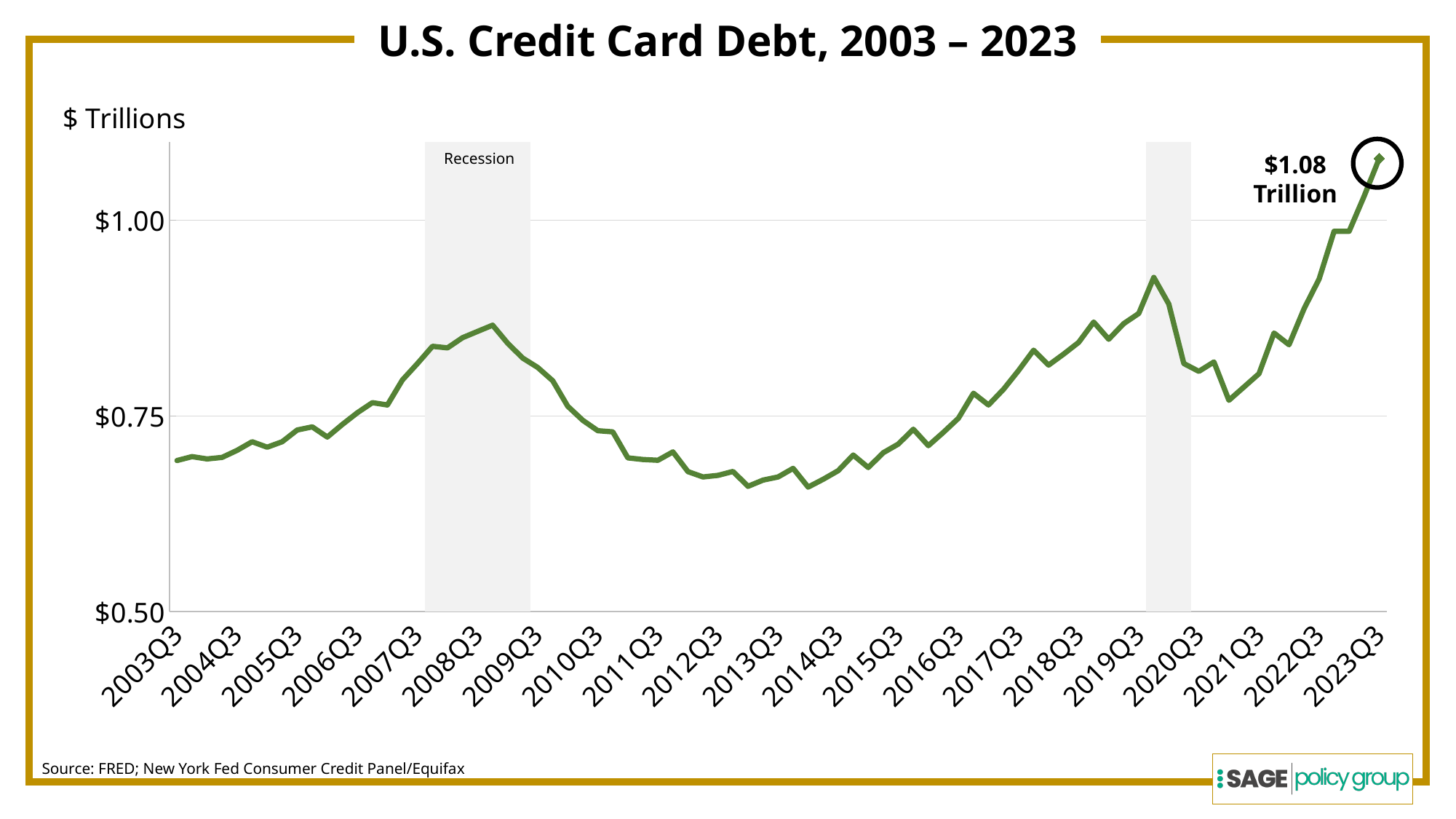
What is the value of U.S. credit card debt at 2023Q3? $1.08 Trillion What unit is shown for the y axis of the chart? $ Trillions Which quarter on the x axis has the highest credit card debt? 2023Q3 What kind of chart is shown on the slide? line chart Is the value for 2008Q3 greater or less than $0.75? greater Does credit card debt rise or fall between 2021Q3 and 2023Q3? rise Is the value for 2013Q3 greater or less than $0.75? less Which is larger, the value for 2008Q3 or the value for 2013Q3? 2008Q3 Does credit card debt rise or fall between 2008Q3 and 2013Q3? fall Is the value for 2019Q3 greater or less than $1.00? less Which is larger, the value for 2019Q3 or the value for 2021Q3? 2019Q3